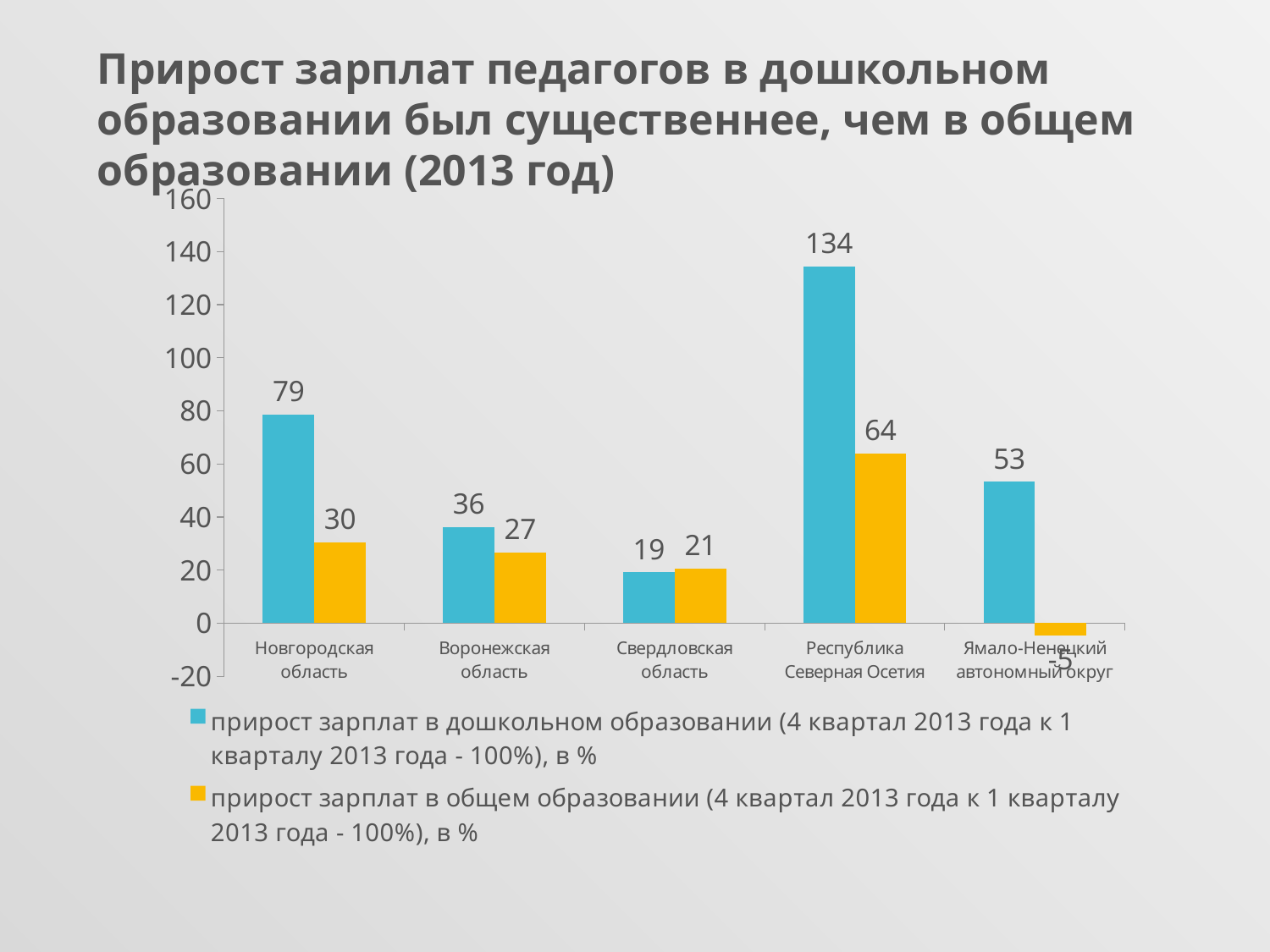
What is the value for Новгородская область in the series 'прирост зарплат в дошкольном образовании'? 79 How many regions are shown on the x axis? 5 What is the value for Республика Северная Осетия in the series 'прирост зарплат в общем образовании'? 64 For Свердловская область, which series has the larger value: 'прирост зарплат в дошкольном образовании' or 'прирост зарплат в общем образовании'? прирост зарплат в общем образовании What colour are the bars for the series 'прирост зарплат в общем образовании'? yellow Which region has the lowest value in the series 'прирост зарплат в общем образовании'? Ямало-Ненецкий автономный округ What is the value for Ямало-Ненецкий автономный округ in the series 'прирост зарплат в общем образовании'? -5 Which region has the highest value in the series 'прирост зарплат в дошкольном образовании'? Республика Северная Осетия What kind of chart is shown on the slide? bar chart How many series does the legend list? 2 What is the difference between the two series' values for Новгородская область? 49 Is the value for Республика Северная Осетия in the series 'прирост зарплат в дошкольном образовании' greater or less than 120? greater